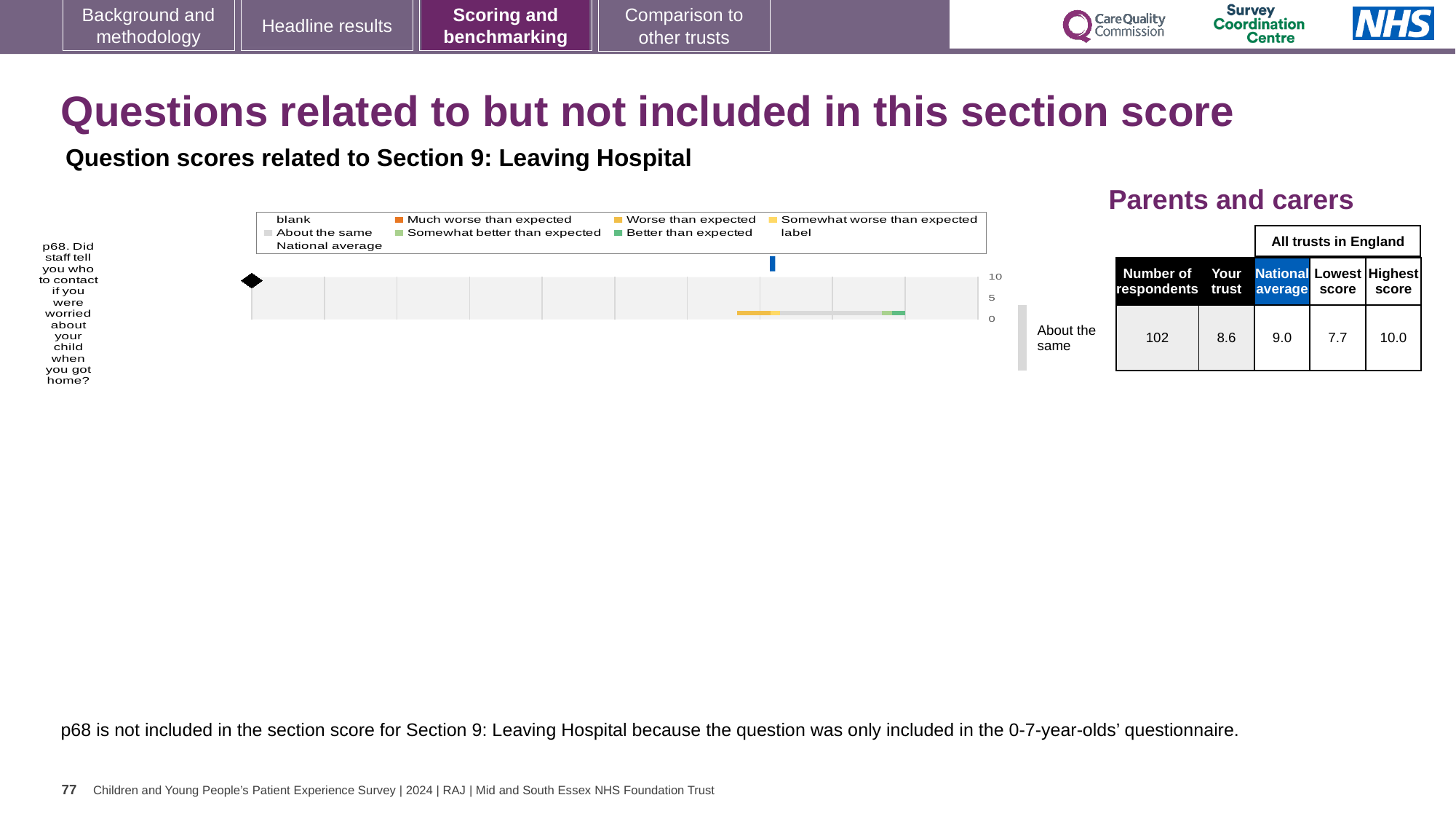
Which benchmarking category is the trust's p68 score placed in? About the same What is the maximum value shown on the chart's score axis? 10 What is the lowest score among all trusts in England for p68? 7.7 How many questions are plotted in the chart? 1 What kind of chart is used to show the p68 question score? bar chart What is the difference between the highest score and the lowest score for p68? 2.3 How many respondents answered p68? 102 What is the 'Your trust' score for p68? 8.6 By how much does the national average exceed the 'Your trust' score for p68? 0.4 What is the national average score for p68? 9.0 Which is larger for p68: the 'Your trust' score or the national average? National average What is the highest score among all trusts in England for p68? 10.0